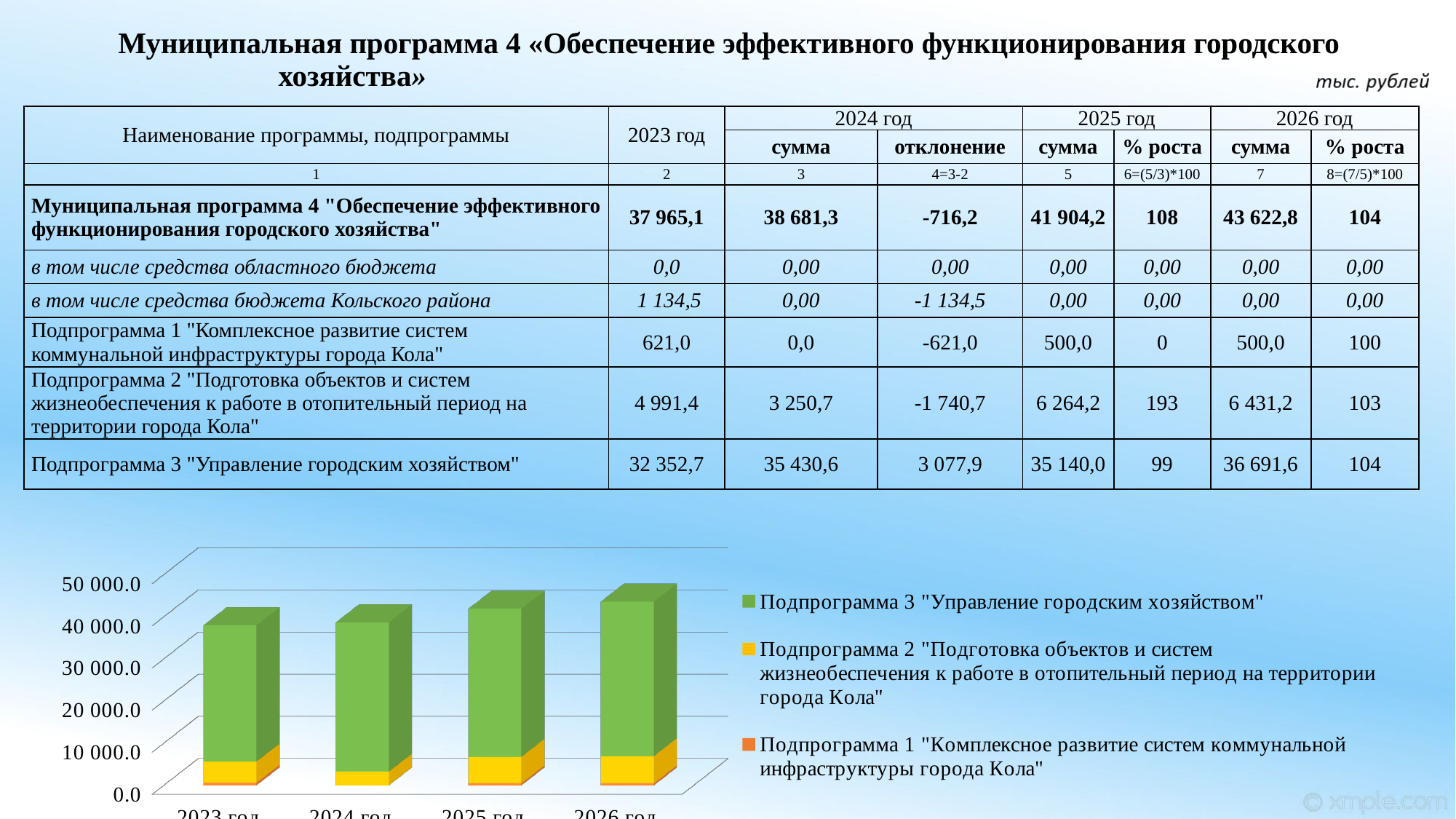
How many series does the chart legend list? 3 Which series is shown in green in the chart? Подпрограмма 3 "Управление городским хозяйством" Is the total height of the bar for 2023 год greater or less than 30 000.0? greater Do the total bar heights generally rise or fall from 2023 год to 2026 год? Rise Is the total height of the bar for 2026 год greater or less than 50 000.0? less Which series occupies the largest portion of each stacked bar? Подпрограмма 3 "Управление городским хозяйством" What kind of chart is shown at the bottom of the slide? Stacked bar chart Which stacked bar is taller, 2025 год or 2024 год? 2025 год Is the total height of the bar for 2025 год greater or less than 40 000.0? greater Which year has the tallest stacked bar in the chart? 2026 год How many years (categories) are shown on the x axis of the chart? 4